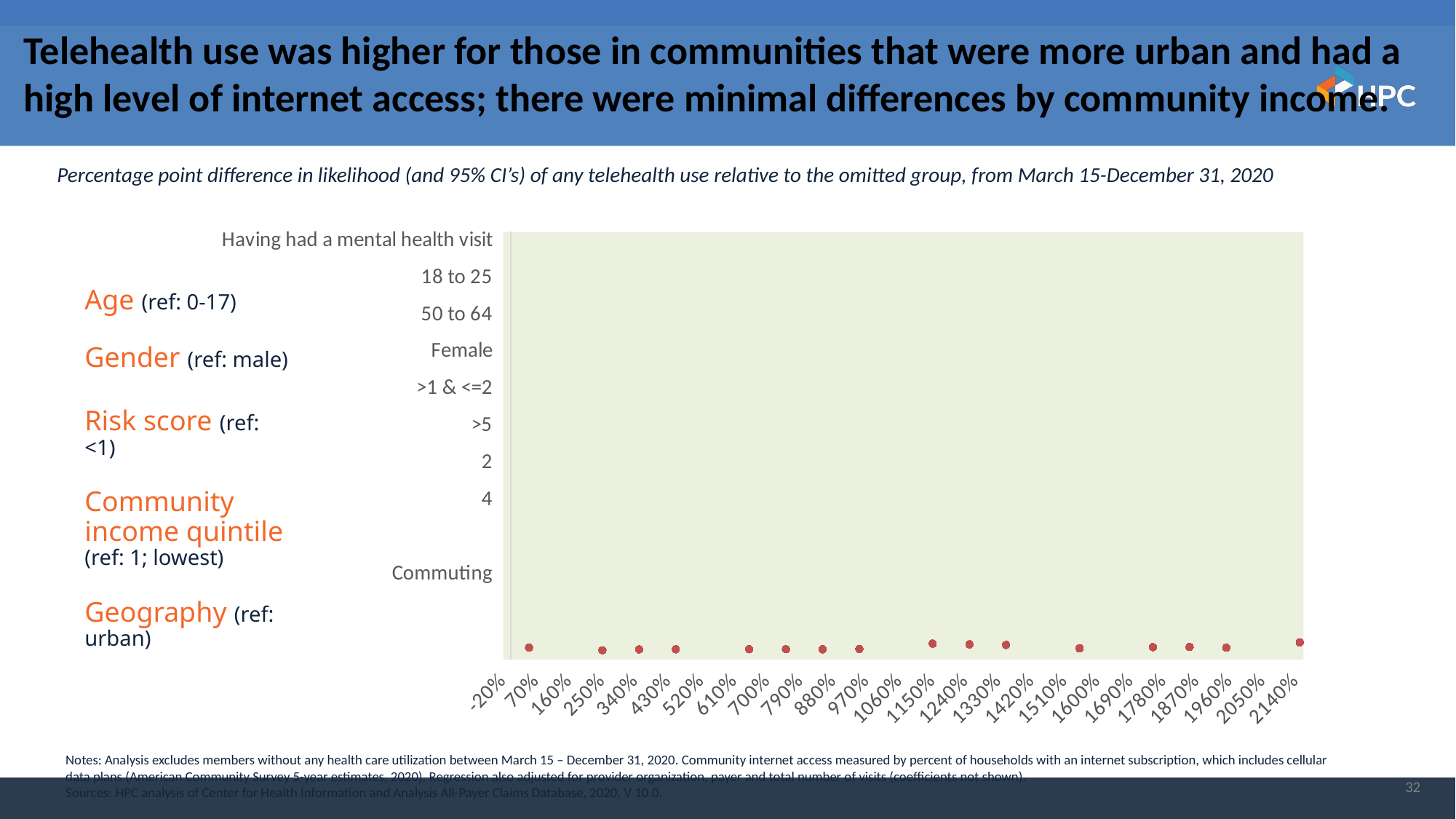
How many red data points are plotted on the chart? 16 How many category labels are listed along the vertical axis of the chart? 9 What is the lowest tick label shown on the horizontal axis of the chart? -20% What kind of chart is shown on the slide? scatter (dot) chart What is the bottommost category label on the vertical axis of the chart? Commuting What is the topmost category label on the vertical axis of the chart? Having had a mental health visit What is the highest tick label shown on the horizontal axis of the chart? 2140%